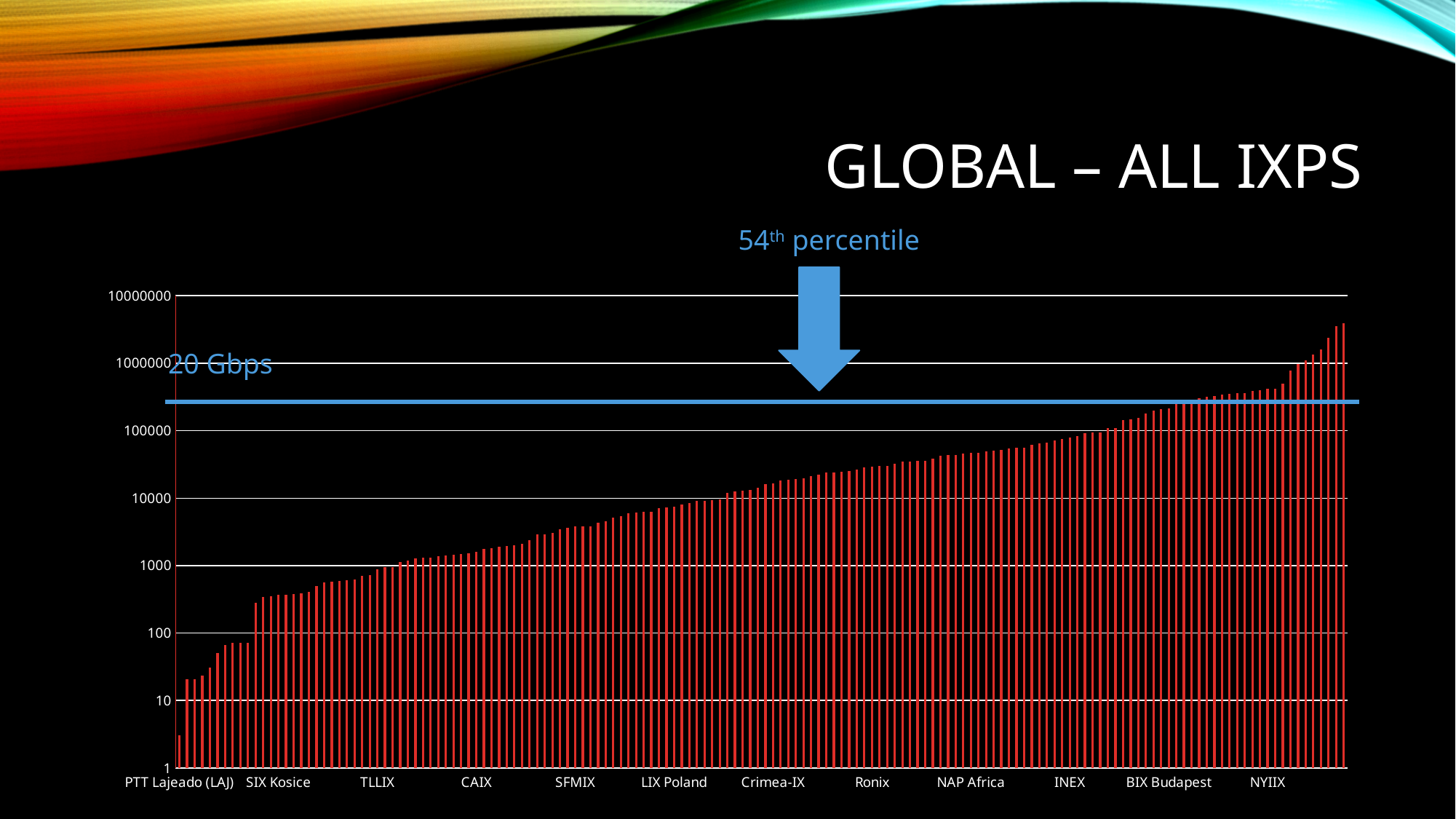
Do the bar values rise or fall from left to right along the x axis? rise Which has the larger value, NYIIX or SIX Kosice? NYIIX What value does the horizontal blue line across the chart represent? 20 Gbps Is the value for SIX Kosice greater or less than 100? greater What is the title of the slide's chart? GLOBAL – ALL IXPS Is the value for SFMIX greater or less than 10000? less Is the value for CAIX greater or less than 1000? greater What kind of chart is shown on the slide? bar chart